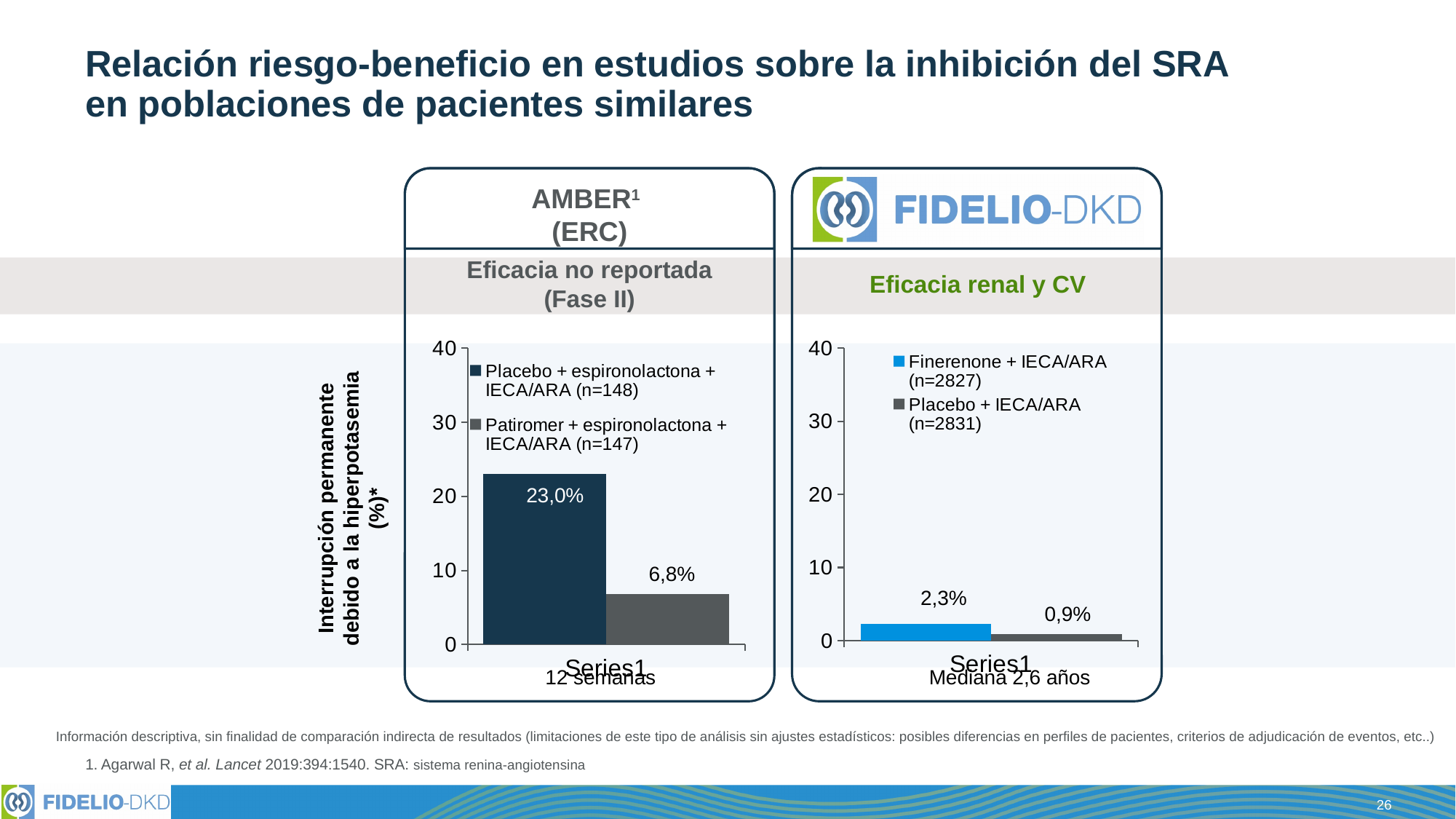
In the AMBER (ERC) chart on the left, what is the difference between the Placebo + espironolactona + IECA/ARA value and the Patiromer + espironolactona + IECA/ARA value? 16,2% In the FIDELIO-DKD chart on the right, which series has the lowest value? Placebo + IECA/ARA (n=2831) In the FIDELIO-DKD chart on the right, what is the value for Placebo + IECA/ARA (n=2831)? 0,9% In the FIDELIO-DKD chart on the right, what is the difference between the Finerenone + IECA/ARA value and the Placebo + IECA/ARA value? 1,4% What kind of chart is the AMBER (ERC) chart on the left? bar chart In the AMBER (ERC) chart on the left, what is the value for Patiromer + espironolactona + IECA/ARA (n=147)? 6,8% In the AMBER (ERC) chart on the left, what is the value for Placebo + espironolactona + IECA/ARA (n=148)? 23,0% In the FIDELIO-DKD chart on the right, which is larger: the value for Finerenone + IECA/ARA or the value for Placebo + IECA/ARA? Finerenone + IECA/ARA In the AMBER (ERC) chart on the left, is the value for Placebo + espironolactona + IECA/ARA greater or less than 20? greater How many series does the legend of the FIDELIO-DKD chart on the right list? 2 In the FIDELIO-DKD chart on the right, what is the value for Finerenone + IECA/ARA (n=2827)? 2,3% In the AMBER (ERC) chart on the left, which series has the highest value? Placebo + espironolactona + IECA/ARA (n=148)